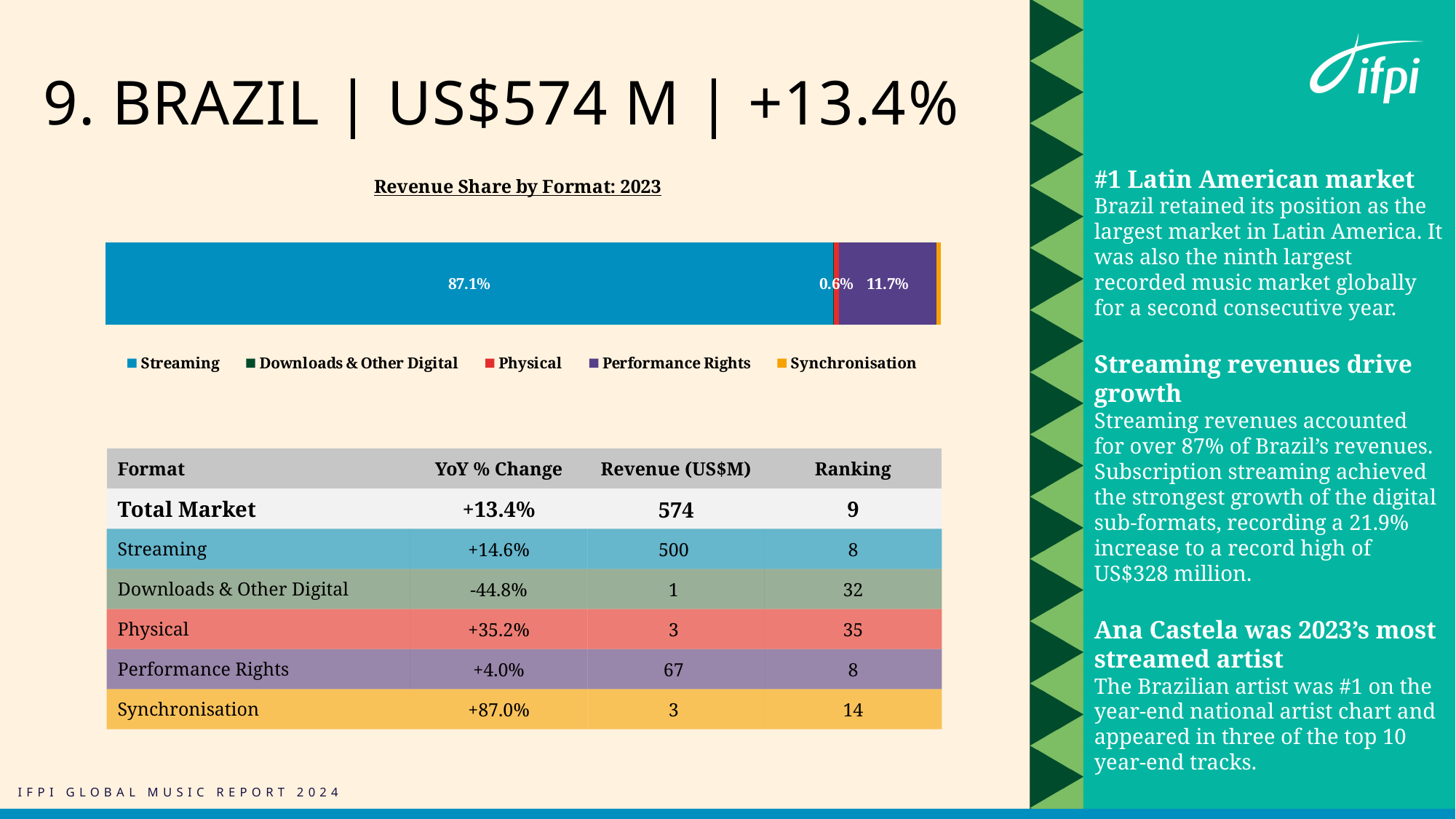
How many series does the legend of the Revenue Share by Format: 2023 chart list? 5 In the Revenue Share by Format: 2023 chart, which is larger: the share for Streaming or the share for Performance Rights? Streaming What is the revenue share for Streaming in the Revenue Share by Format: 2023 chart? 87.1% What kind of chart is the Revenue Share by Format: 2023 chart? Stacked bar chart Which format has the largest revenue share in the Revenue Share by Format: 2023 chart? Streaming In the Revenue Share by Format: 2023 chart, which is larger: the share for Physical or the share for Performance Rights? Performance Rights What is the revenue share for Physical in the Revenue Share by Format: 2023 chart? 0.6% Which colour represents Streaming in the Revenue Share by Format: 2023 chart? Blue What is the title of the chart on the slide? Revenue Share by Format: 2023 What is the revenue share for Performance Rights in the Revenue Share by Format: 2023 chart? 11.7% In the Revenue Share by Format: 2023 chart, how many percentage points larger is the Streaming share than the Performance Rights share? 75.4 percentage points In the Revenue Share by Format: 2023 chart, what is the difference between the Performance Rights share and the Physical share? 11.1 percentage points